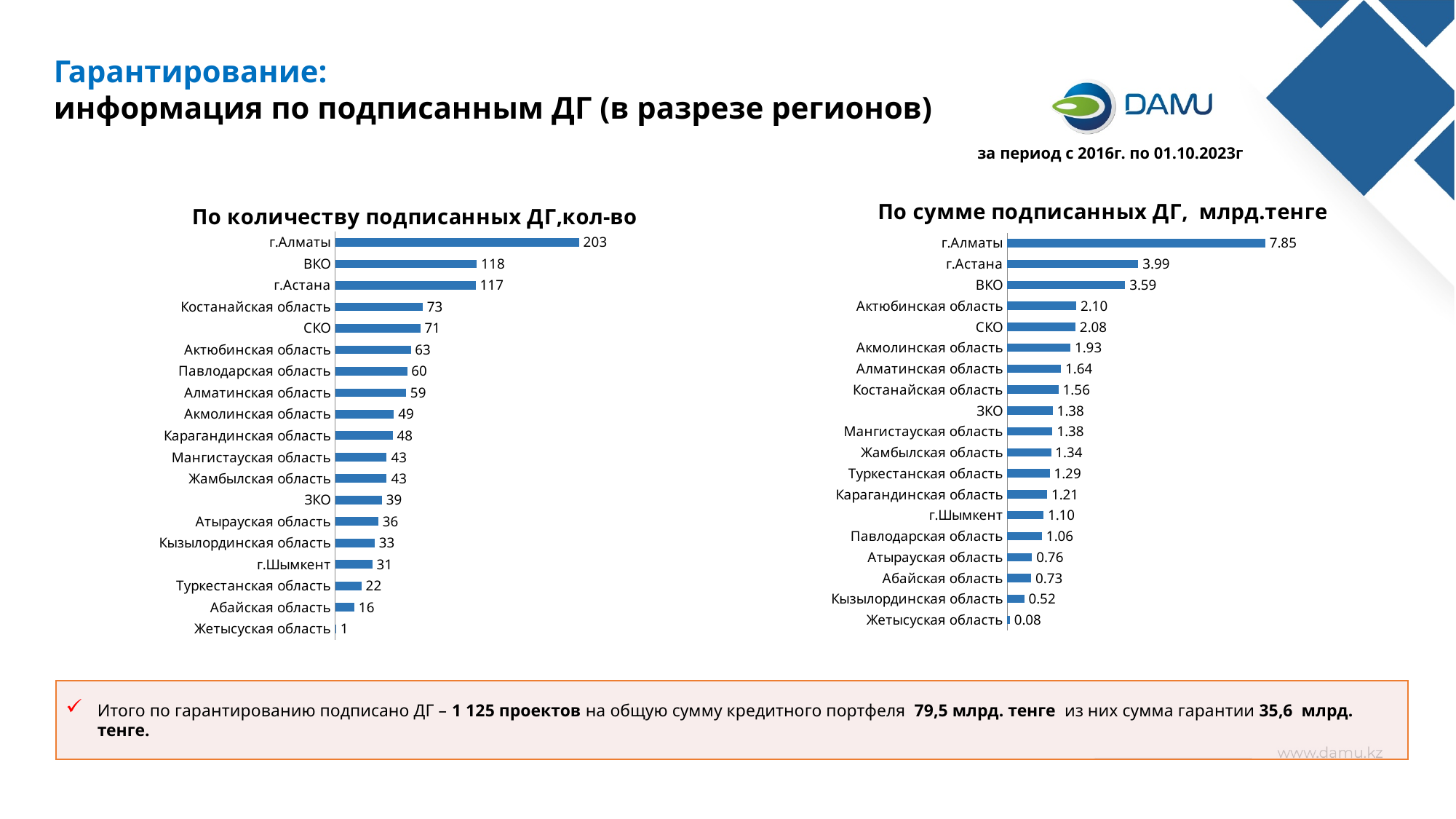
In the chart 'По сумме подписанных ДГ, млрд.тенге', what is the value for г.Астана? 3.99 What period does the slide state the data covers? с 2016г. по 01.10.2023г In the chart 'По количеству подписанных ДГ,кол-во', which region has the lowest value? Жетысуская область In the chart 'По сумме подписанных ДГ, млрд.тенге', what is the value for Жетысуская область? 0.08 In the chart 'По сумме подписанных ДГ, млрд.тенге', which is larger: Актюбинская область or Павлодарская область? Актюбинская область In the chart 'По сумме подписанных ДГ, млрд.тенге', which region has the highest value? г.Алматы What type of chart is 'По количеству подписанных ДГ,кол-во'? Bar chart In the chart 'По сумме подписанных ДГ, млрд.тенге', what is the difference between г.Алматы and ВКО? 4.26 In the chart 'По количеству подписанных ДГ,кол-во', what is the value for Костанайская область? 73 In the chart 'По количеству подписанных ДГ,кол-во', what is the difference between ВКО and г.Астана? 1 In the chart 'По количеству подписанных ДГ,кол-во', how many regions are shown? 19 In the chart 'По количеству подписанных ДГ,кол-во', what is the value for г.Алматы? 203